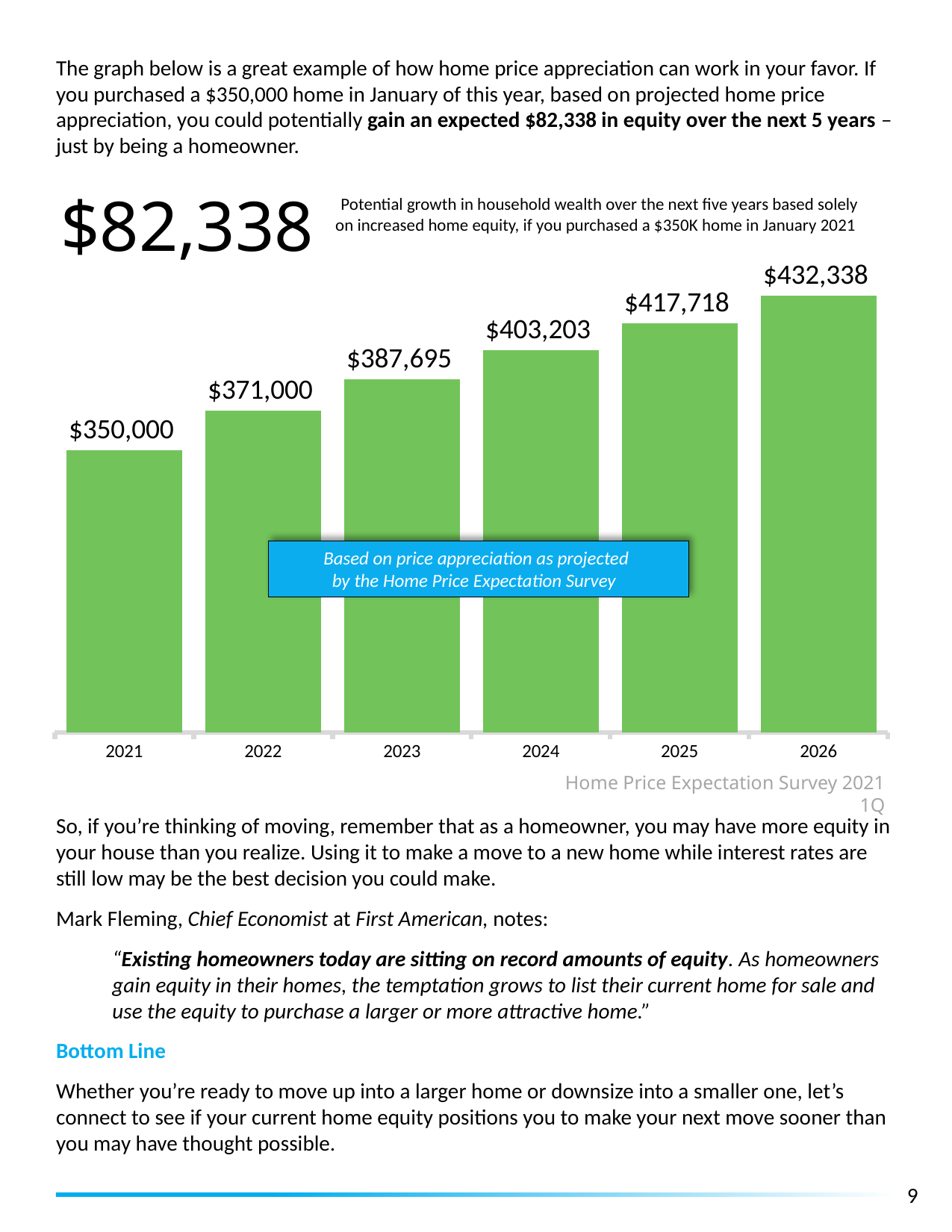
What is the difference between the 2026 value and the 2021 value? $82,338 Which year has the lowest value? 2021 Which is larger, the value for 2023 or the value for 2025? 2025 What is the difference between the 2022 value and the 2021 value? $21,000 Which year has the highest value? 2026 What source is cited below the chart? Home Price Expectation Survey 2021 1Q What is the value shown for 2021? $350,000 How many years are shown on the x axis? 6 Do the values rise or fall from 2021 to 2026? rise What is the value shown for 2024? $403,203 What is the value shown for 2026? $432,338 What kind of chart is this? bar chart